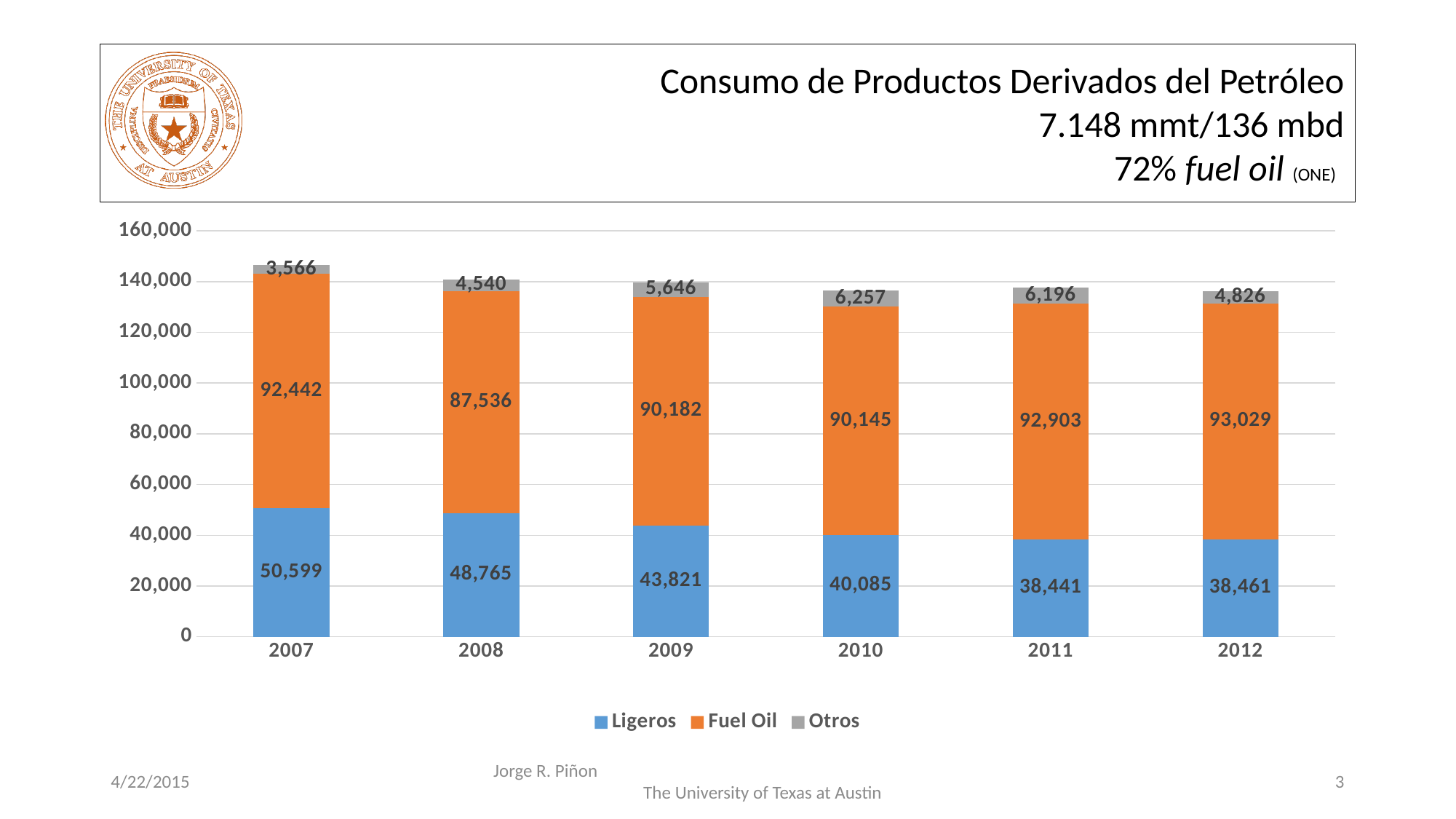
What is the Otros value for 2012? 4,826 What kind of chart is shown on the slide? Stacked bar chart Which is larger, the Fuel Oil value for 2009 or for 2011? 2011 Does the Ligeros value rise or fall from 2007 to 2011? Fall What is the total of the stacked bar for 2007? 146,607 What is the difference between the Ligeros values for 2007 and 2012? 12,138 In which year is the Fuel Oil value lowest? 2008 How many years are shown on the x axis? 6 What is the Fuel Oil value for 2010? 90,145 What is the Ligeros value for 2007? 50,599 How many series does the legend list? 3 In which year is the Otros value highest? 2010